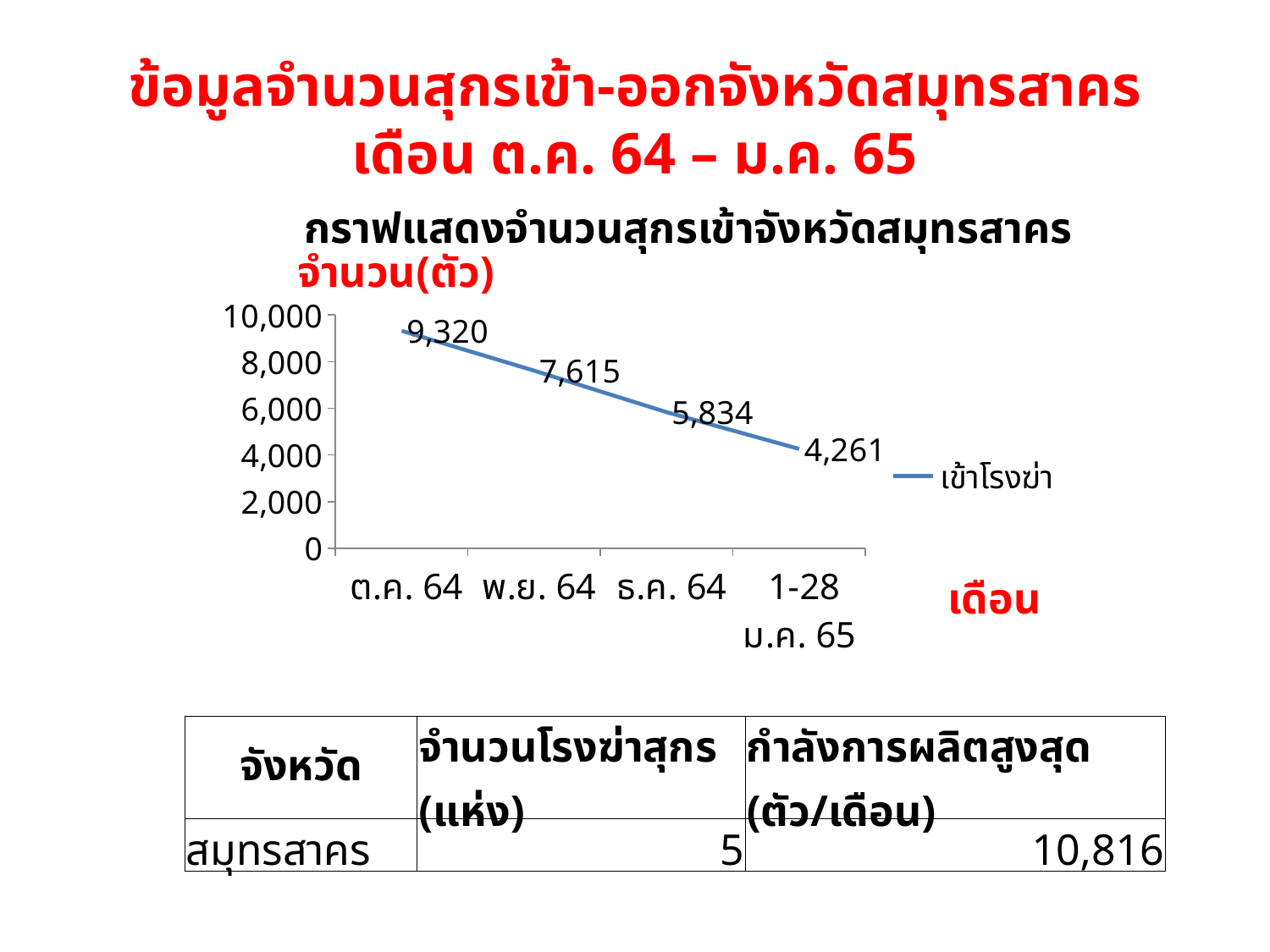
What kind of chart is shown on the slide? line chart What is the value for ธ.ค. 64 in the chart? 5,834 What is the value for พ.ย. 64 in the chart? 7,615 Do the values rise or fall from ต.ค. 64 to 1-28 ม.ค. 65? fall What is the difference between the values for ธ.ค. 64 and 1-28 ม.ค. 65? 1,573 What is the value for 1-28 ม.ค. 65 in the chart? 4,261 Which is larger, the value for พ.ย. 64 or the value for ธ.ค. 64? พ.ย. 64 Which month has the lowest value in the chart? 1-28 ม.ค. 65 Which month has the highest value in the chart? ต.ค. 64 What is the value for ต.ค. 64 in the chart? 9,320 What is the difference between the values for ต.ค. 64 and พ.ย. 64? 1,705 How many data points are plotted in the chart? 4